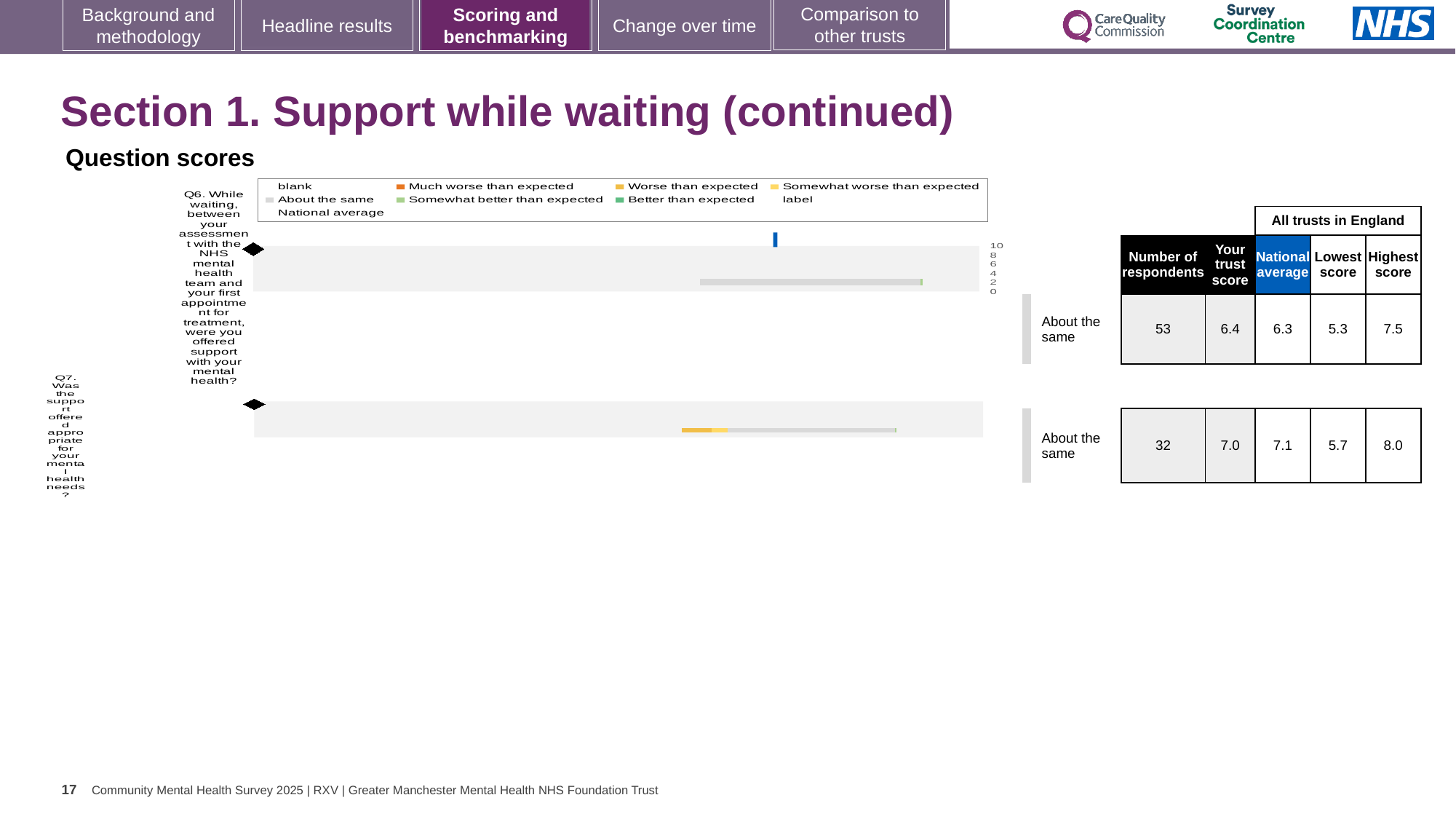
How many questions (bars) are plotted in the question scores chart? 2 What is the difference between the highest and lowest scores for Q6? 2.2 Which question had more respondents, Q6 or Q7? Q6 How many respondents answered Q6? 53 What type of chart is used to show the question scores on this slide? Bar chart What is the maximum value shown on the score axis of the chart? 10 What is the difference between the highest and lowest scores for Q7? 2.3 What is the highest score among all trusts in England for Q7? 8.0 For Q6, which is larger: your trust score or the national average? Your trust score What is the lowest score among all trusts in England for Q7? 5.7 What is the 'Your trust score' value for Q6 in the question scores table? 6.4 What is the national average score for Q7? 7.1